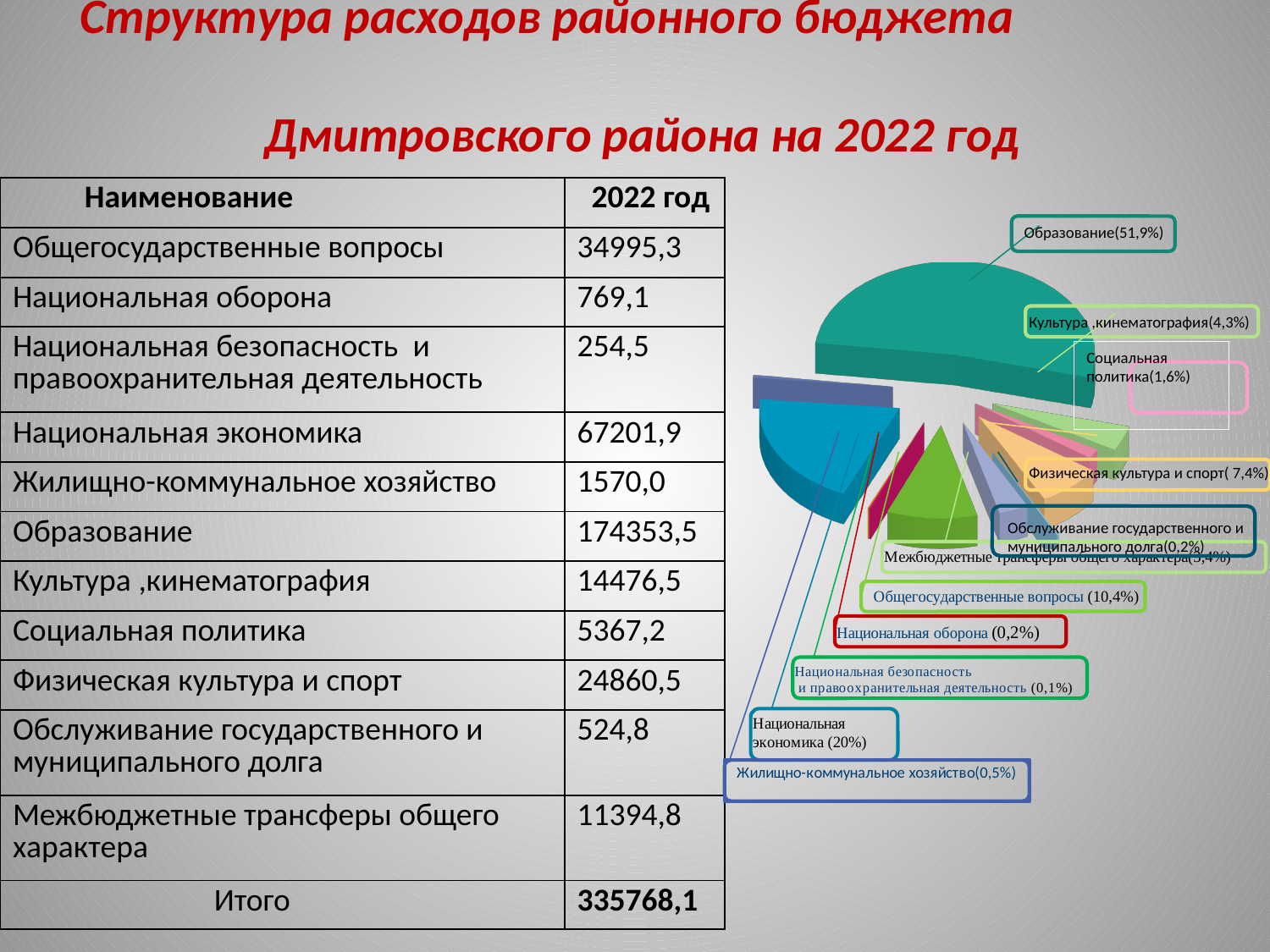
By how many percentage points does the Образование share exceed the Национальная экономика share in the pie chart? 31,9 Which category has the largest slice of the pie chart? Образование What share of the pie chart does Физическая культура и спорт have? 7,4% Which slice is larger in the pie chart: Культура, кинематография or Физическая культура и спорт? Физическая культура и спорт What share of the pie chart does Общегосударственные вопросы have? 10,4% What share of the pie chart does Жилищно-коммунальное хозяйство have? 0,5% Which category has the smallest slice of the pie chart? Национальная безопасность и правоохранительная деятельность How many slices does the pie chart have? 11 What kind of chart is shown on the slide? pie chart